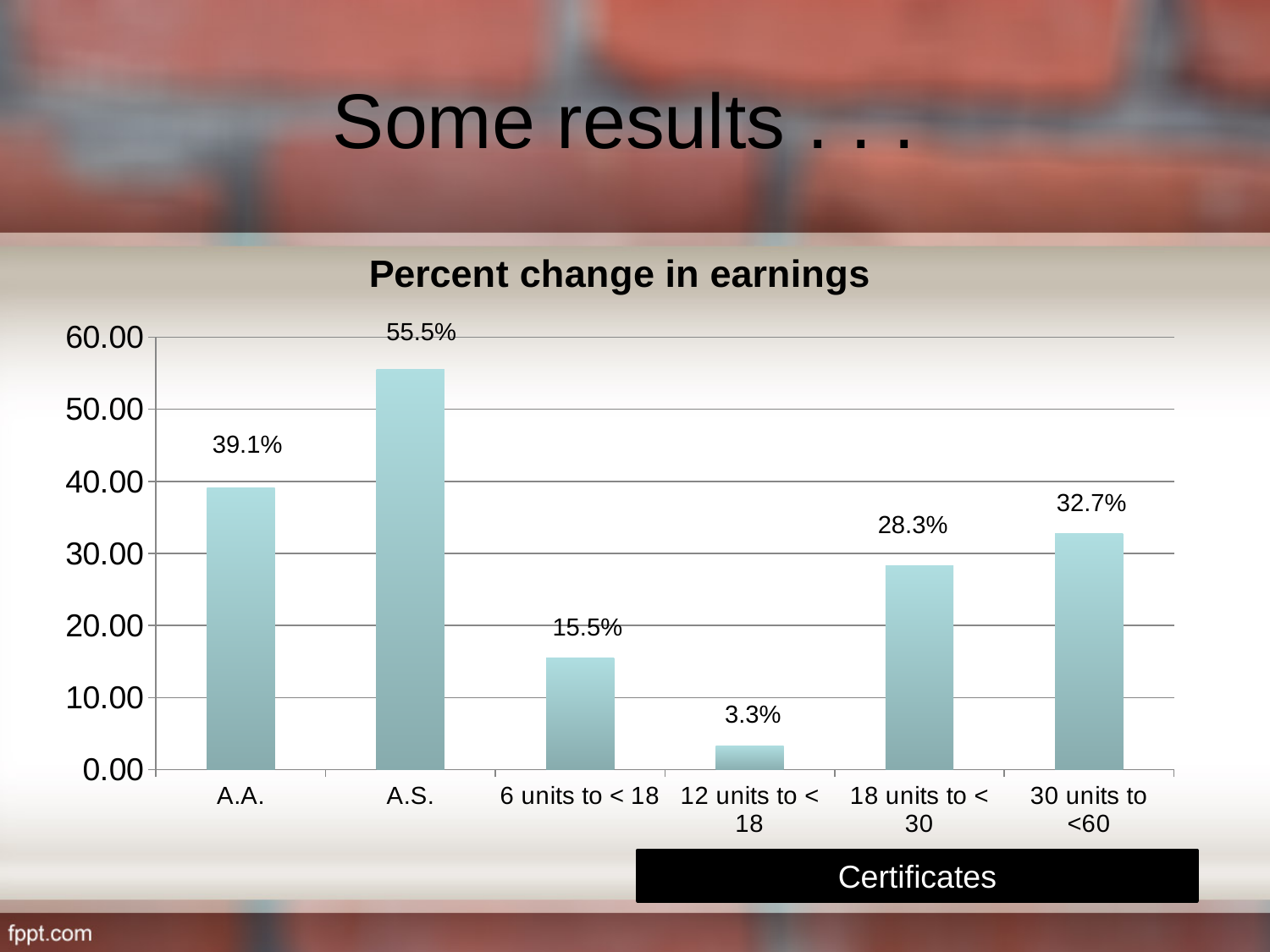
What is the title of the chart? Percent change in earnings Which category has the highest percent change in earnings? A.S. Which has a larger percent change in earnings, A.A. or 18 units to < 30? A.A. Which category has the lowest percent change in earnings? 12 units to < 18 What kind of chart is shown on the slide? bar chart How many categories are shown on the chart? 6 What is the difference between the percent change in earnings for 30 units to <60 and 18 units to < 30? 4.4% What is the percent change in earnings for A.S.? 55.5% What is the percent change in earnings for the 12 units to < 18 category? 3.3% Is the value for 6 units to < 18 greater or less than 20.00? less What is the difference between the percent change in earnings for A.S. and A.A.? 16.4% What is the percent change in earnings for the 30 units to <60 category? 32.7%